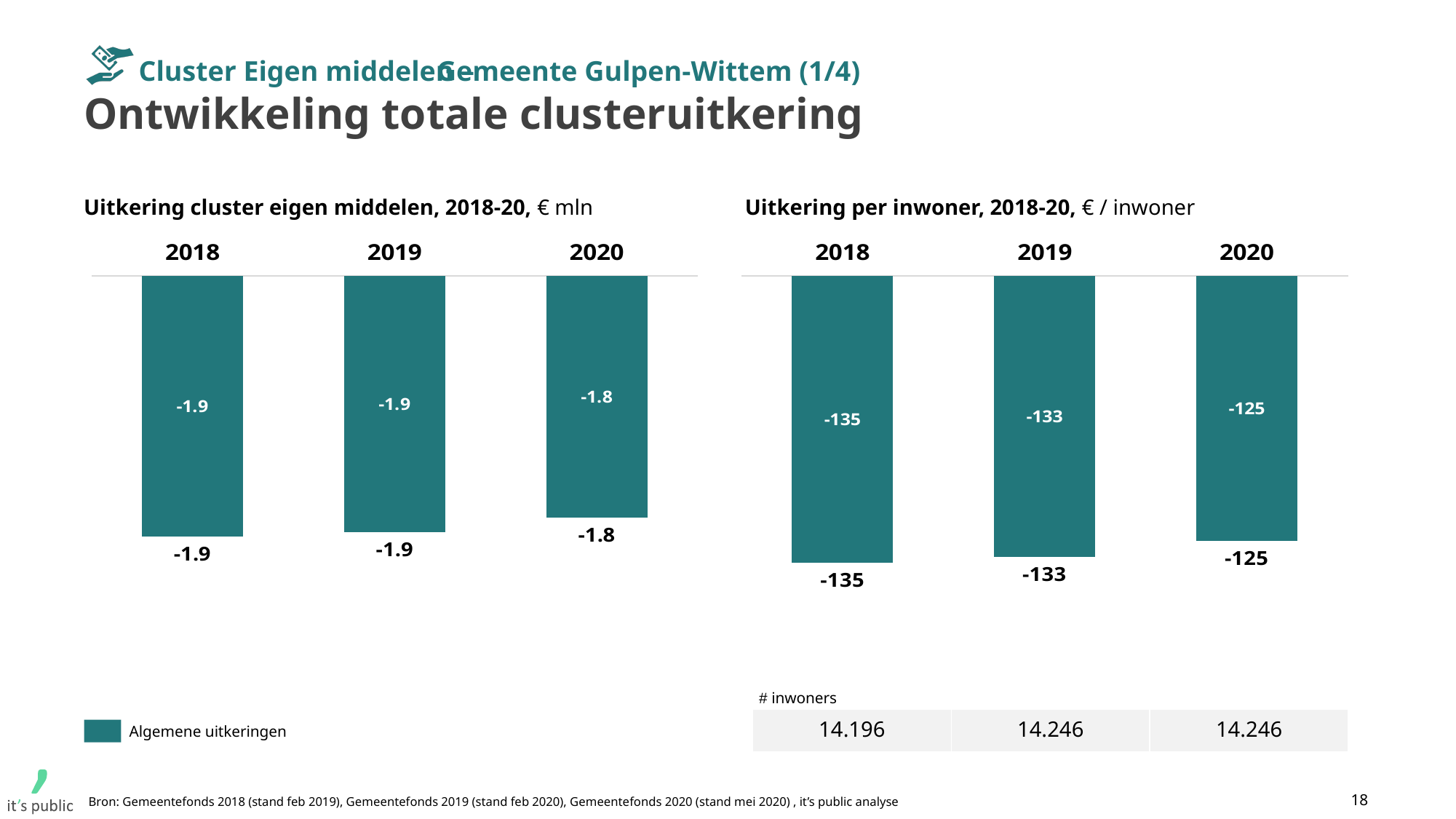
In the chart 'Uitkering per inwoner, 2018-20', is the value for 2019 larger than the value for 2018? Yes In the chart 'Uitkering per inwoner, 2018-20', do the values rise or fall from 2018 to 2020? Rise In the chart 'Uitkering per inwoner, 2018-20', what is the value for 2020? -125 In the chart 'Uitkering cluster eigen middelen, 2018-20', what is the value for 2018? -1.9 In the chart 'Uitkering per inwoner, 2018-20', which year has the lowest value? 2018 In the chart 'Uitkering per inwoner, 2018-20', what is the difference between the values for 2018 and 2020? 10 How many years are shown in the chart 'Uitkering cluster eigen middelen, 2018-20'? 3 What series name does the legend on the slide show? Algemene uitkeringen What kind of chart is 'Uitkering per inwoner, 2018-20'? Bar chart In the chart 'Uitkering per inwoner, 2018-20', which year has the highest value? 2020 In the chart 'Uitkering cluster eigen middelen, 2018-20', what is the value for 2020? -1.8 In the chart 'Uitkering per inwoner, 2018-20', what is the value for 2019? -133